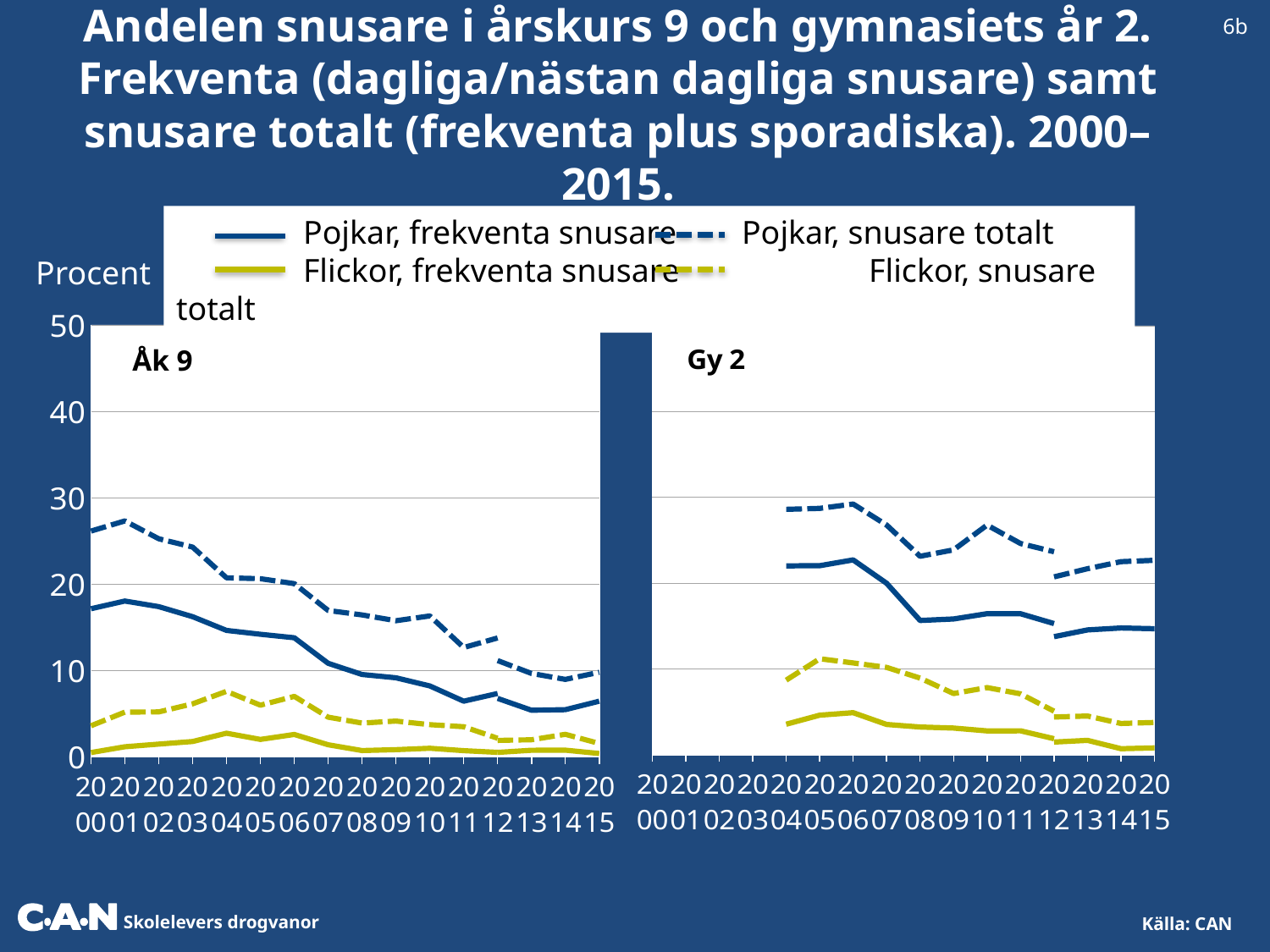
What label is shown on the vertical axis of the charts? Procent In the Åk 9 chart, how many years are shown on the x axis? 16 How many series does the legend list? 4 In the Åk 9 chart, which is larger in 2000: Pojkar, frekventa snusare or Flickor, frekventa snusare? Pojkar, frekventa snusare In the Åk 9 chart, is the value for Pojkar, snusare totalt in 2001 greater or less than 20? greater In the Åk 9 chart, is the value for Pojkar, frekventa snusare in 2015 greater or less than 10? less What kind of chart is used on this slide for the Åk 9 and Gy 2 panels? Line chart In the Gy 2 chart, is the value for Flickor, frekventa snusare in 2015 greater or less than 10? less In the Gy 2 chart, which is larger in 2015: Pojkar, snusare totalt or Flickor, snusare totalt? Pojkar, snusare totalt In the Åk 9 chart, does the Pojkar, frekventa snusare line generally rise or fall from 2000 to 2015? Fall In the Åk 9 chart, which series has the highest value in 2001? Pojkar, snusare totalt